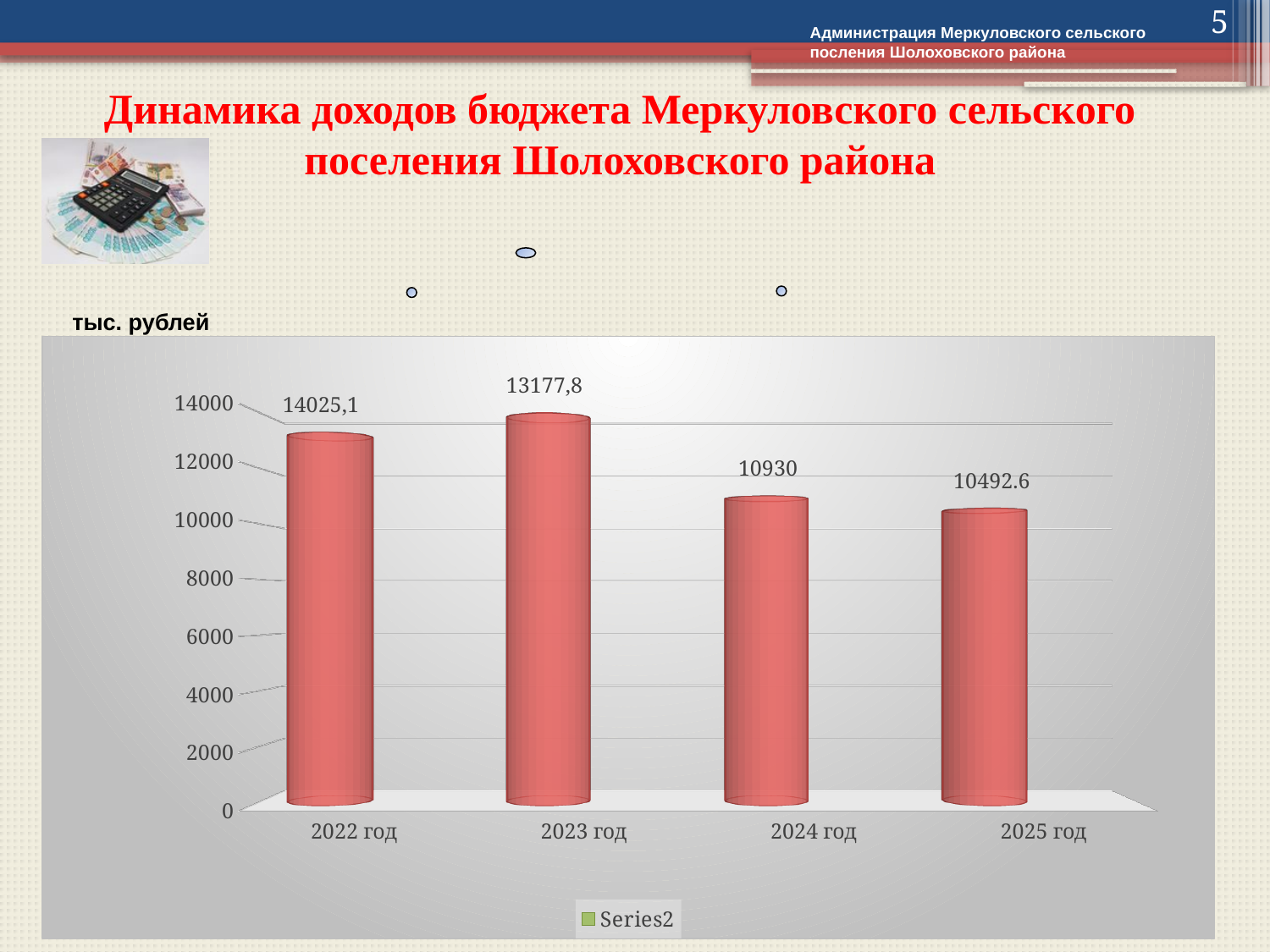
What is the value for 2022 год? 14025,1 What is the value for 2024 год? 10930 What is the difference between the values for 2024 год and 2025 год? 437.4 Is the value for 2025 год greater or less than 10000? greater What series name is shown in the legend? Series2 What is the value for 2023 год? 13177,8 Which is larger, the value for 2024 год or 2025 год? 2024 год How many years are shown on the x axis? 4 How many series does the legend list? 1 Which year has the lowest value? 2025 год What kind of chart is shown on the slide? bar chart What is the value for 2025 год? 10492.6